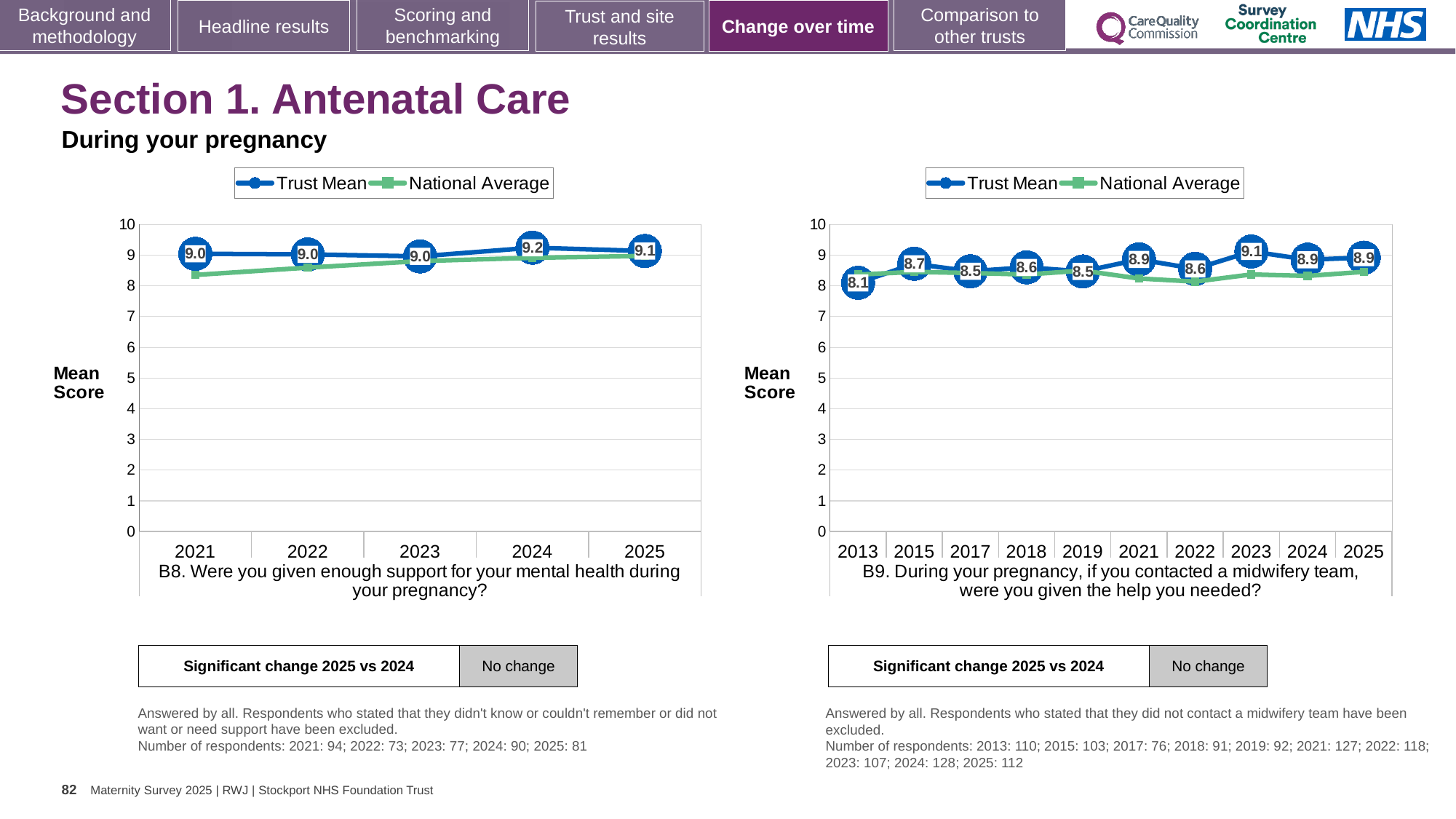
In the B9 chart on the right, what is the Trust Mean for 2013? 8.1 In the B8 chart on the left, what is the difference between the Trust Mean for 2024 and 2021? 0.2 In the B9 chart on the right, is the National Average for 2013 greater or less than 9? less In the B9 chart on the right, which year has the lowest Trust Mean? 2013 In the B8 chart on the left, how many years are shown on the x axis? 5 In the B9 chart on the right, what is the difference between the Trust Mean for 2023 and 2013? 1.0 In the B9 chart on the right, which year has the highest Trust Mean? 2023 In the B9 chart on the right, how many years are shown on the x axis? 10 In the B8 chart on the left, what is the Trust Mean for 2024? 9.2 How many series does the legend of the B8 chart on the left list? 2 In the B8 chart on the left, which year has the highest Trust Mean? 2024 In the B8 chart on the left, what is the Trust Mean for 2021? 9.0